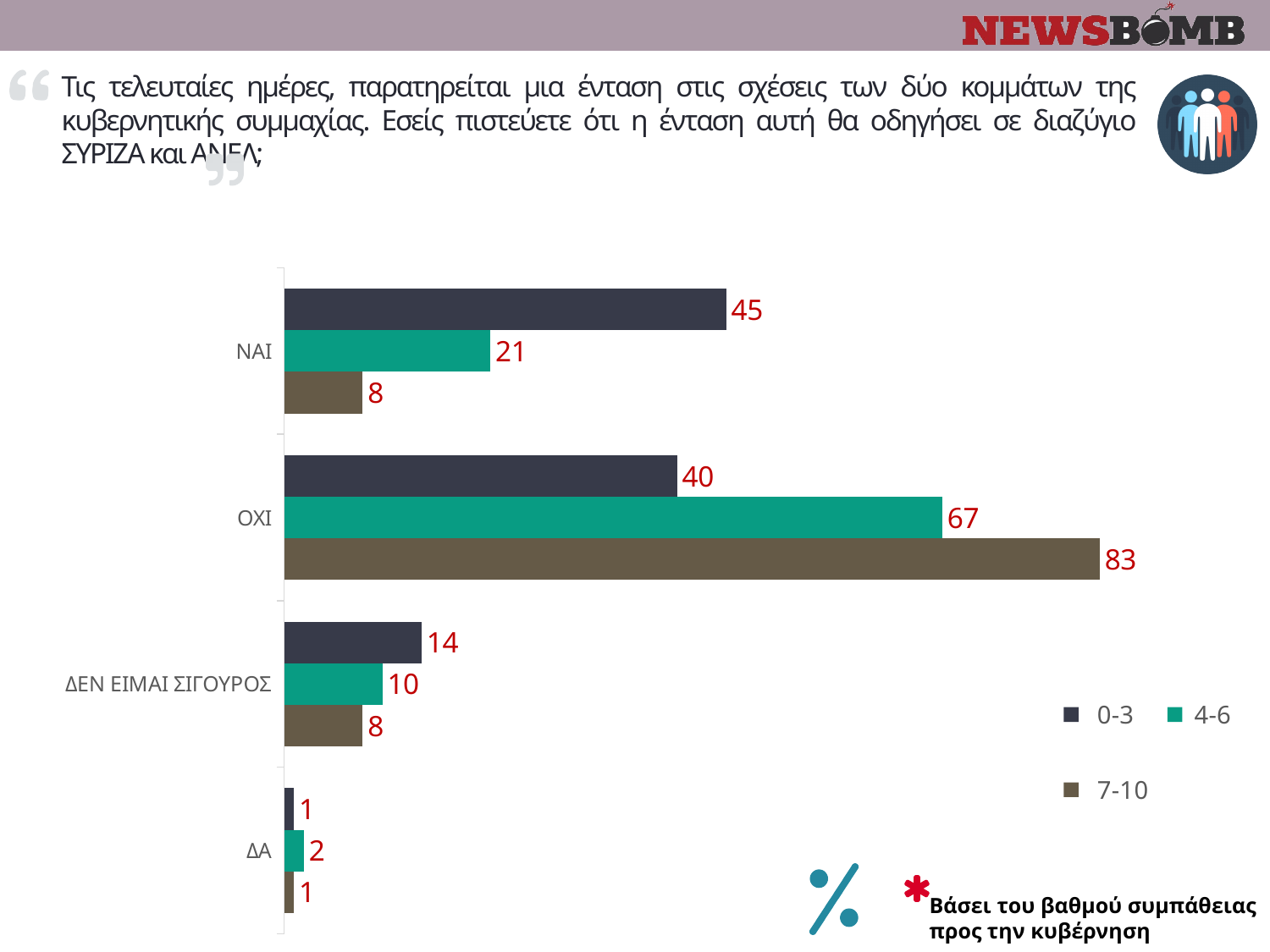
What kind of chart is shown on the slide? Bar chart What is the difference between the 7-10 value and the 0-3 value for ΟΧΙ? 43 How many response categories are shown on the chart? 4 What is the value for ΟΧΙ in the 7-10 series? 83 What is the value for ΔΕΝ ΕΙΜΑΙ ΣΙΓΟΥΡΟΣ in the 4-6 series? 10 Which is larger for ΝΑΙ: the 0-3 value or the 4-6 value? 0-3 Which category has the lowest value in the 0-3 series? ΔΑ Which category has the highest value in the 7-10 series? ΟΧΙ What is the difference between the 0-3 value and the 4-6 value for ΝΑΙ? 24 What is the value for ΝΑΙ in the 0-3 series? 45 What is the value for ΔΑ in the 4-6 series? 2 How many series does the legend list? 3